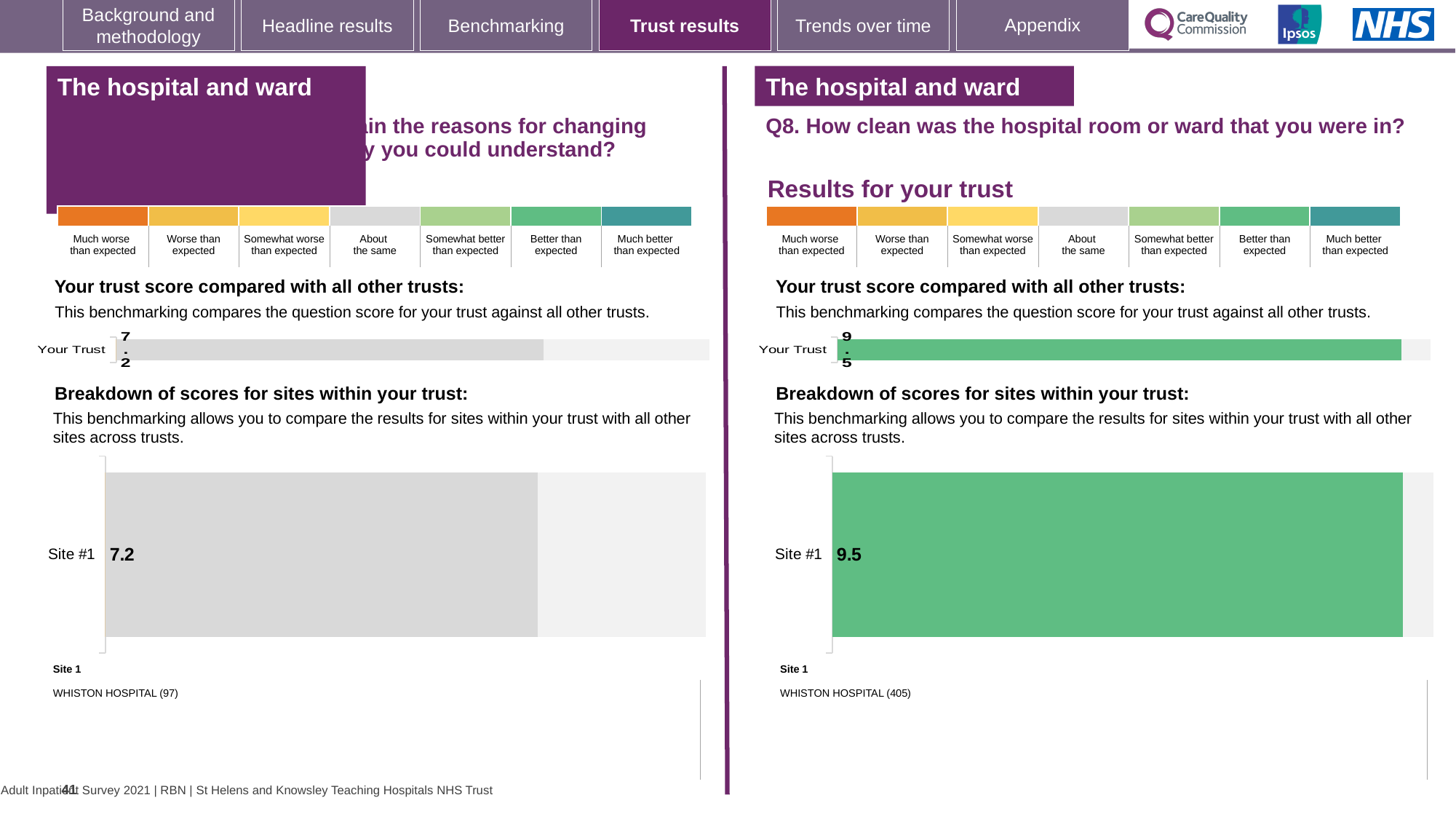
How many sites are shown in the right-hand breakdown chart for Q8? 1 Which is larger: the Site #1 score on the left-hand breakdown chart or the Site #1 score on the right-hand breakdown chart for Q8? The right-hand chart (Q8) What is the difference between the Your Trust score on the right-hand Q8 chart and the Your Trust score on the left-hand chart? 2.3 On the left-hand breakdown chart of scores for sites within your trust, what is the score shown for Site #1? 7.2 Which site name is listed under Site 1 on the right-hand Q8 breakdown chart? WHISTON HOSPITAL (405) On the right-hand chart for Q8 (how clean was the hospital room or ward), what is the score shown for Your Trust? 9.5 What colour is the Site #1 bar on the right-hand Q8 breakdown chart? Green On the left-hand 'Your trust score compared with all other trusts' chart, what is the score shown for Your Trust? 7.2 On the right-hand breakdown chart for Q8, what is the score shown for Site #1? 9.5 How many sites are shown in the left-hand breakdown chart of scores for sites within your trust? 1 What type of chart is used to show the Site #1 score on the right-hand Q8 breakdown? Bar chart